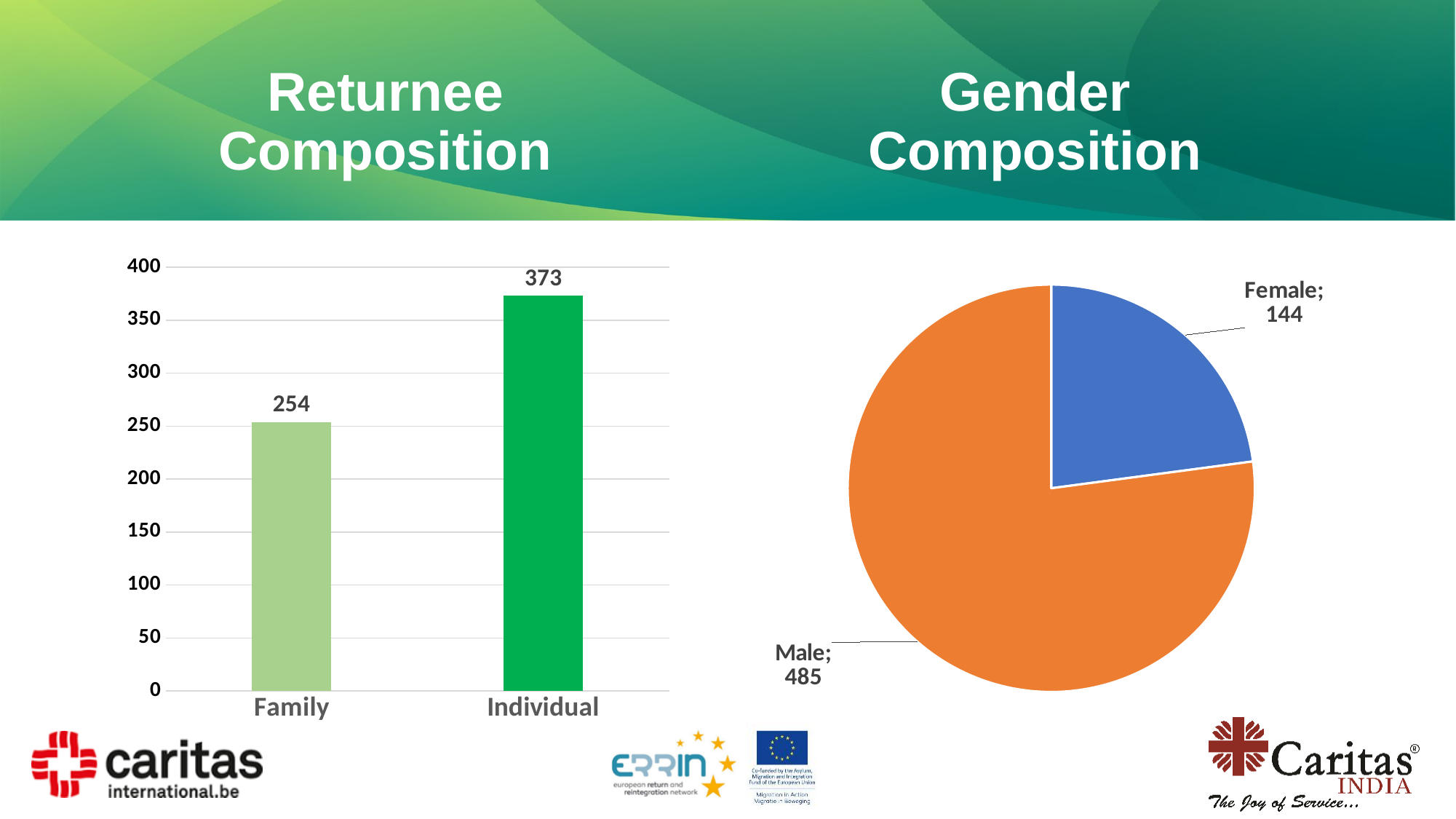
In the Returnee Composition chart, what is the value for Family? 254 In the Returnee Composition chart, is the value for Family greater or less than 300? less In the Returnee Composition chart, which category has the highest value? Individual In the Returnee Composition chart, what is the value for Individual? 373 What kind of chart is the Gender Composition chart? pie chart In the Gender Composition chart, what is the total of the Male and Female values? 629 In the Returnee Composition chart, what is the difference between the Individual and Family values? 119 In the Gender Composition chart, what is the value for Male? 485 In the Gender Composition chart, which slice is larger, Male or Female? Male What kind of chart is the Returnee Composition chart? bar chart In the Returnee Composition chart, how many categories are shown? 2 In the Gender Composition chart, what is the value for Female? 144